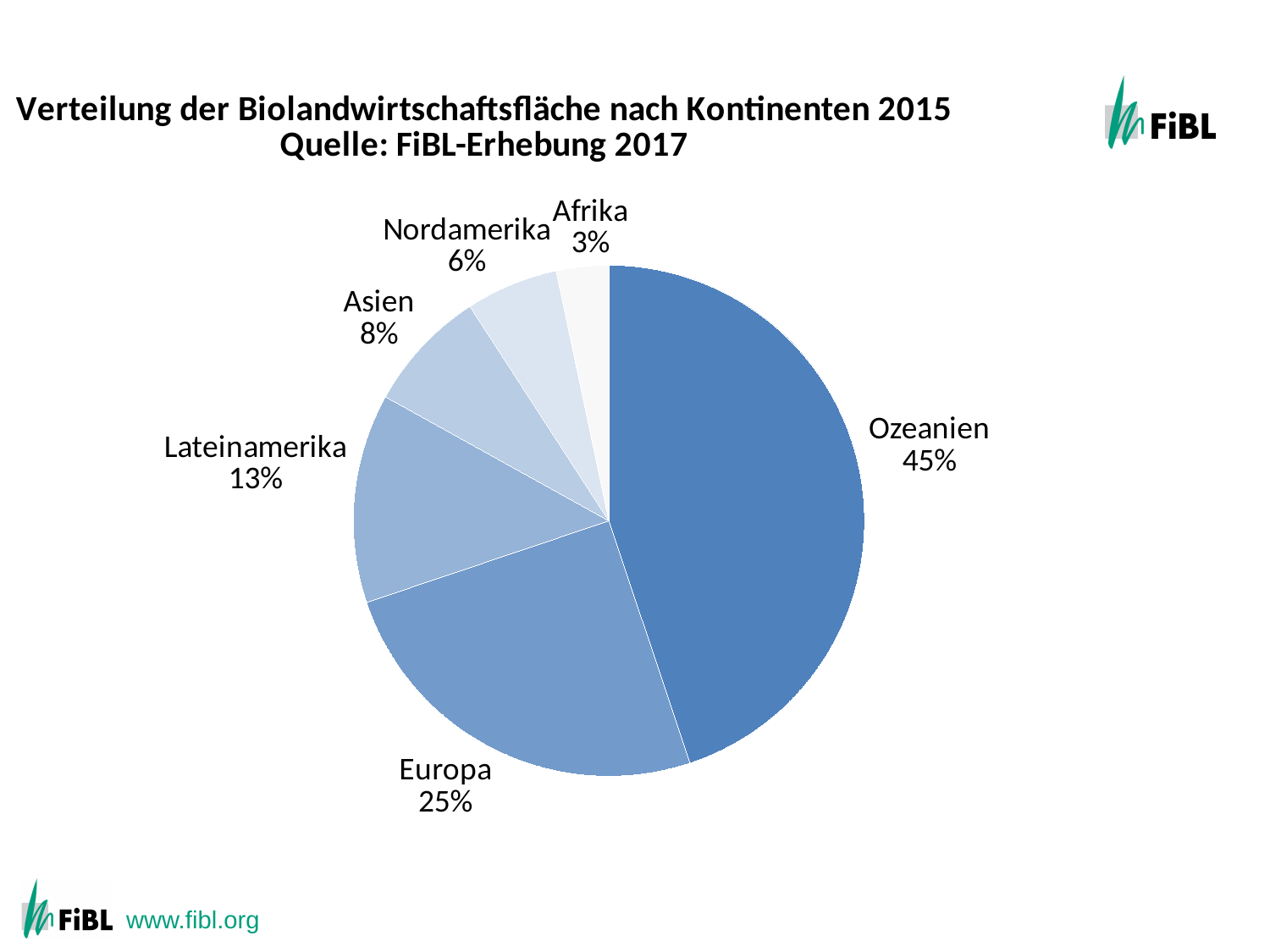
What is the value shown for Lateinamerika? 13% What share of the pie does Ozeanien have? 45% How many continents are shown in the pie chart? 6 What is the title of the chart? Verteilung der Biolandwirtschaftsfläche nach Kontinenten 2015 Quelle: FiBL-Erhebung 2017 What is the value shown for Asien? 8% Which continent has the smallest share of the pie? Afrika What is the value shown for Europa? 25% Which continent has the largest share of the pie? Ozeanien What kind of chart is shown on the slide? Pie chart Which has a larger share, Lateinamerika or Asien? Lateinamerika What is the difference in percentage points between Ozeanien and Europa? 20 What is the value shown for Nordamerika? 6%